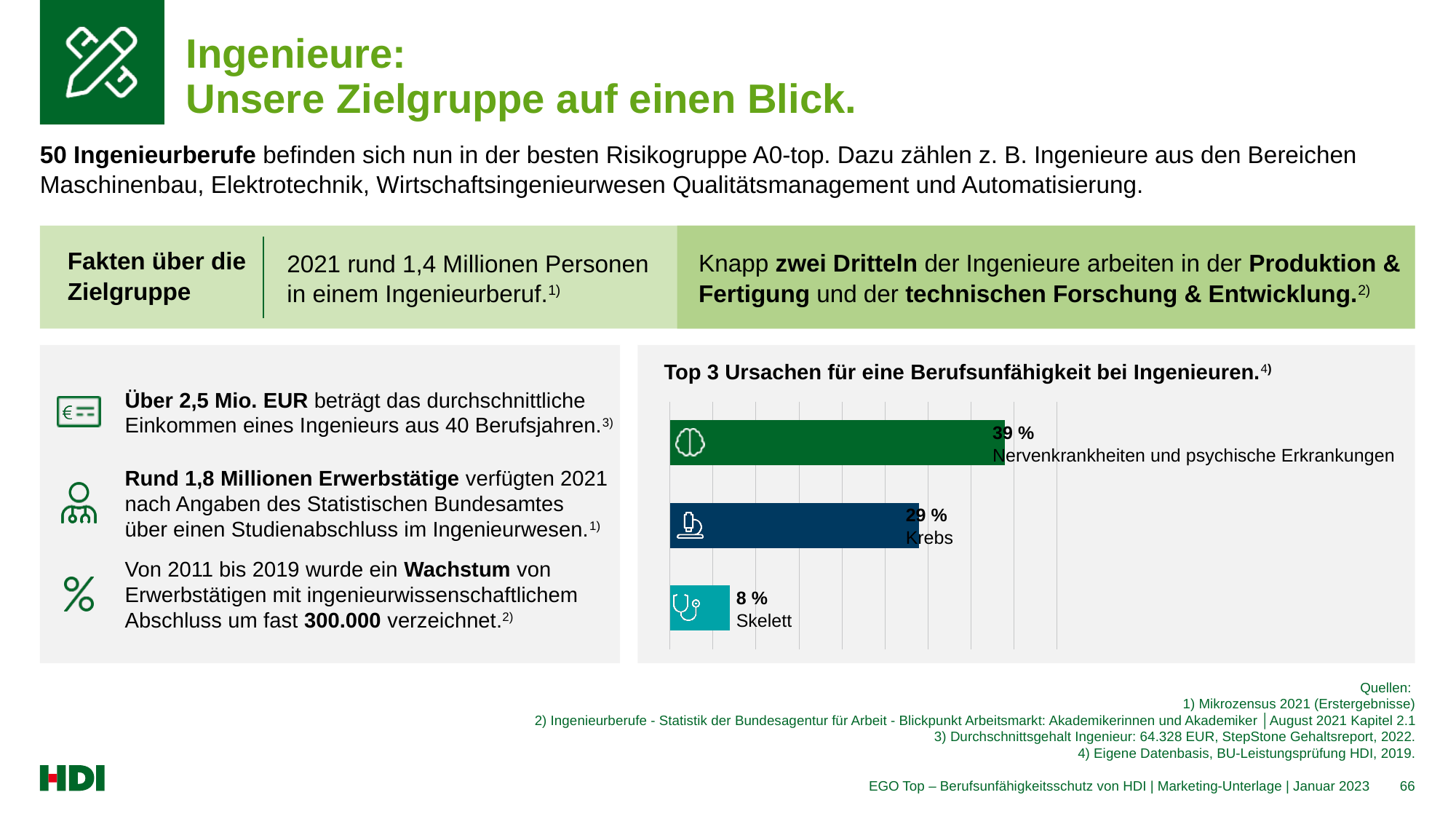
What is the value for Krebs in the chart? 29 % What is the difference between the values for Nervenkrankheiten und psychische Erkrankungen and Krebs? 10 % Which is larger, the value for Krebs or the value for Skelett? Krebs What kind of chart is shown on the slide? Bar chart Which category has the lowest value in the chart? Skelett What colour is the bar for Skelett? Teal Which category has the highest value in the chart? Nervenkrankheiten und psychische Erkrankungen What is the value for Nervenkrankheiten und psychische Erkrankungen in the chart? 39 % What is the value for Skelett in the chart? 8 % What is the title of the chart? Top 3 Ursachen für eine Berufsunfähigkeit bei Ingenieuren. How many categories are shown in the chart? 3 What is the difference between the values for Krebs and Skelett? 21 %